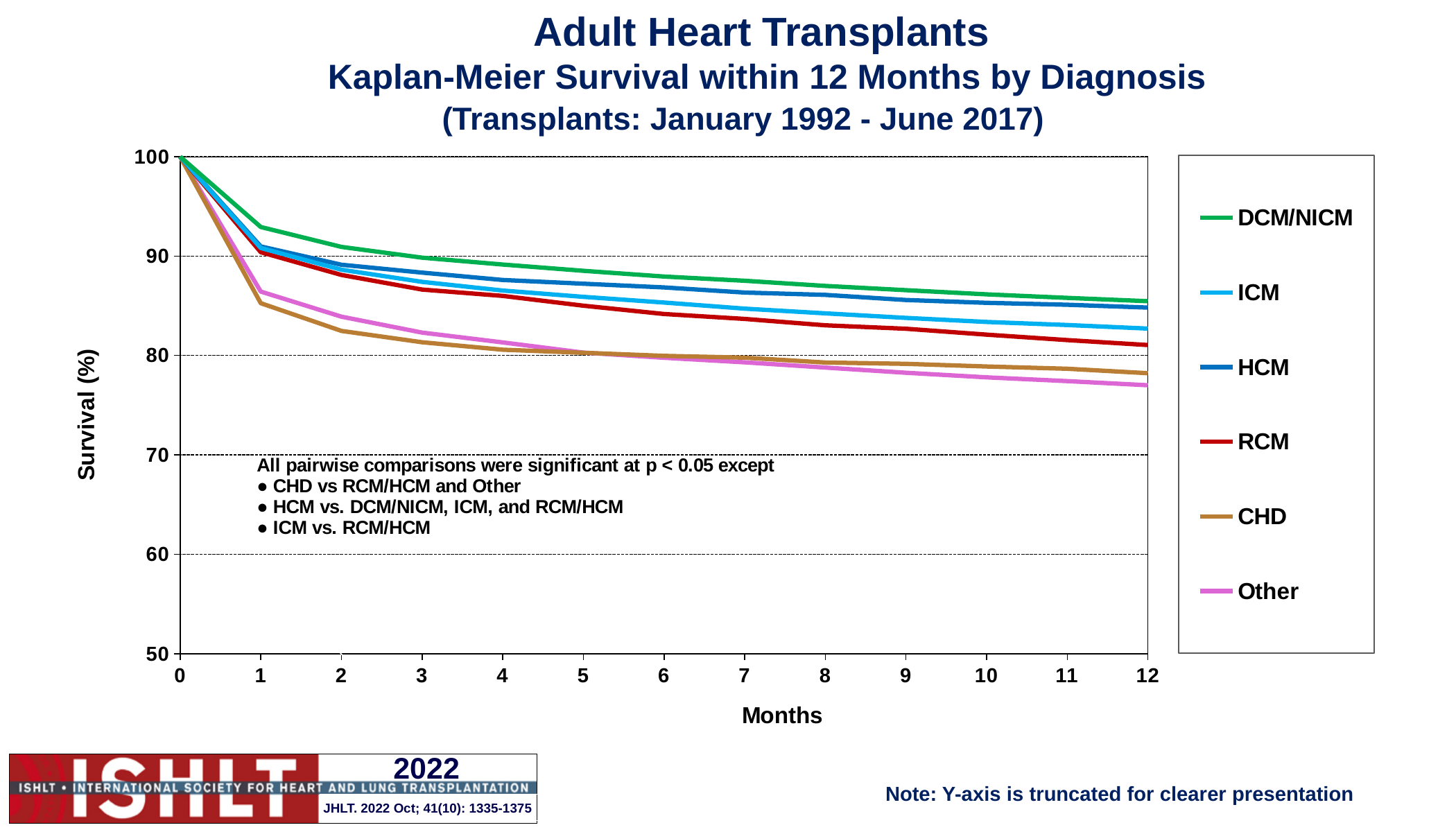
Is the survival value for DCM/NICM at 12 months greater or less than 80? greater Which diagnosis group has the highest survival at 12 months? DCM/NICM Is the survival value for Other at 12 months greater or less than 80? less Which diagnosis group has the lowest survival at 1 month? CHD At 6 months, which has higher survival: DCM/NICM or CHD? DCM/NICM How many series does the legend list? 6 Is the survival value for CHD at 1 month greater or less than 90? less What is the survival value for DCM/NICM at 0 months? 100 What is the label of the y-axis? Survival (%) What kind of chart is shown on the slide? Line chart Do the survival curves rise or fall as months increase? Fall